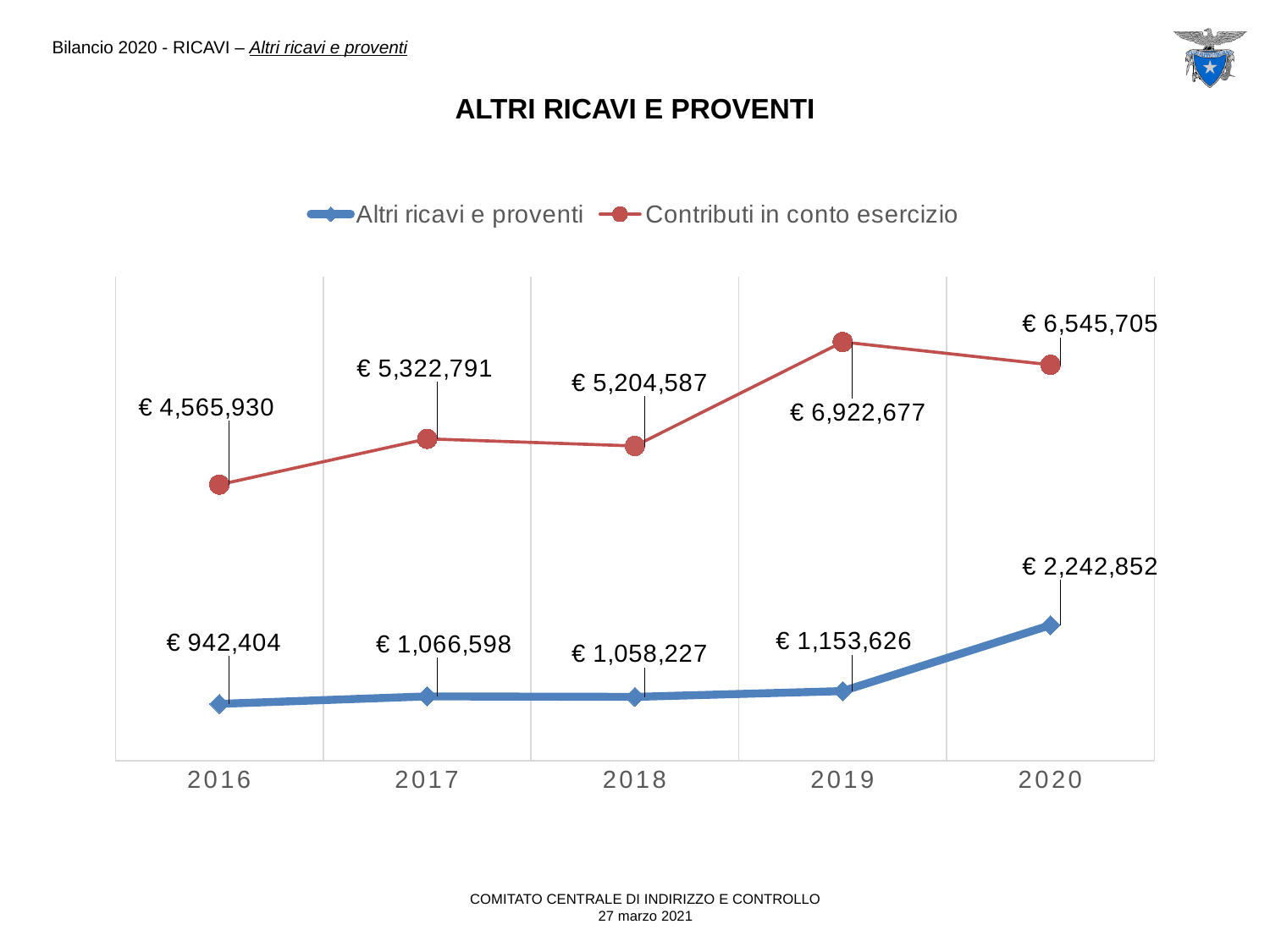
What is the value of Contributi in conto esercizio in 2018? € 5,204,587 Which is larger for Altri ricavi e proventi: the 2017 value or the 2018 value? 2017 What is the value of Altri ricavi e proventi in 2019? € 1,153,626 By how much did Altri ricavi e proventi increase from 2019 to 2020? € 1,089,226 What is the difference between Contributi in conto esercizio in 2019 and in 2020? € 376,972 What kind of chart is shown on the slide? Line chart What is the value of Altri ricavi e proventi in 2020? € 2,242,852 In which year is Contributi in conto esercizio highest? 2019 In which year is Altri ricavi e proventi lowest? 2016 How many years are shown on the x axis? 5 How many series does the legend list? 2 What is the value of Contributi in conto esercizio in 2016? € 4,565,930